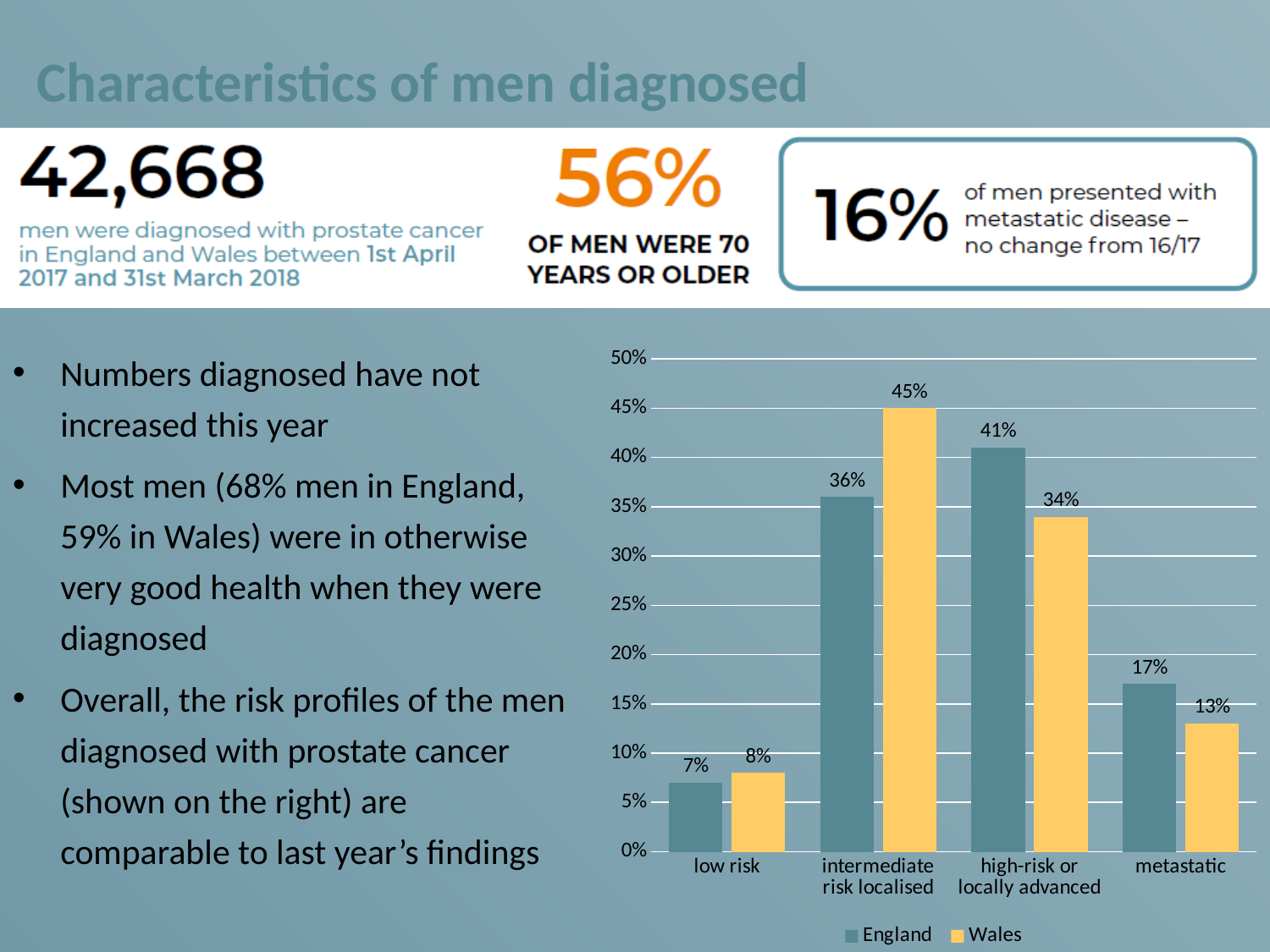
What is the difference between the Wales and England values in the intermediate risk localised category? 9% How many categories are shown on the x axis of the chart? 4 Which category has the highest value for England? high-risk or locally advanced Is the value for England in the metastatic category greater or less than 20%? less What is the value for England in the intermediate risk localised category? 36% Which category has the lowest value for Wales? low risk What is the value for Wales in the low risk category? 8% What kind of chart is shown on the slide? bar chart What is the value for Wales in the metastatic category? 13% Which is larger in the high-risk or locally advanced category, England or Wales? England Which colour represents Wales in the chart? yellow How many series does the chart legend list? 2